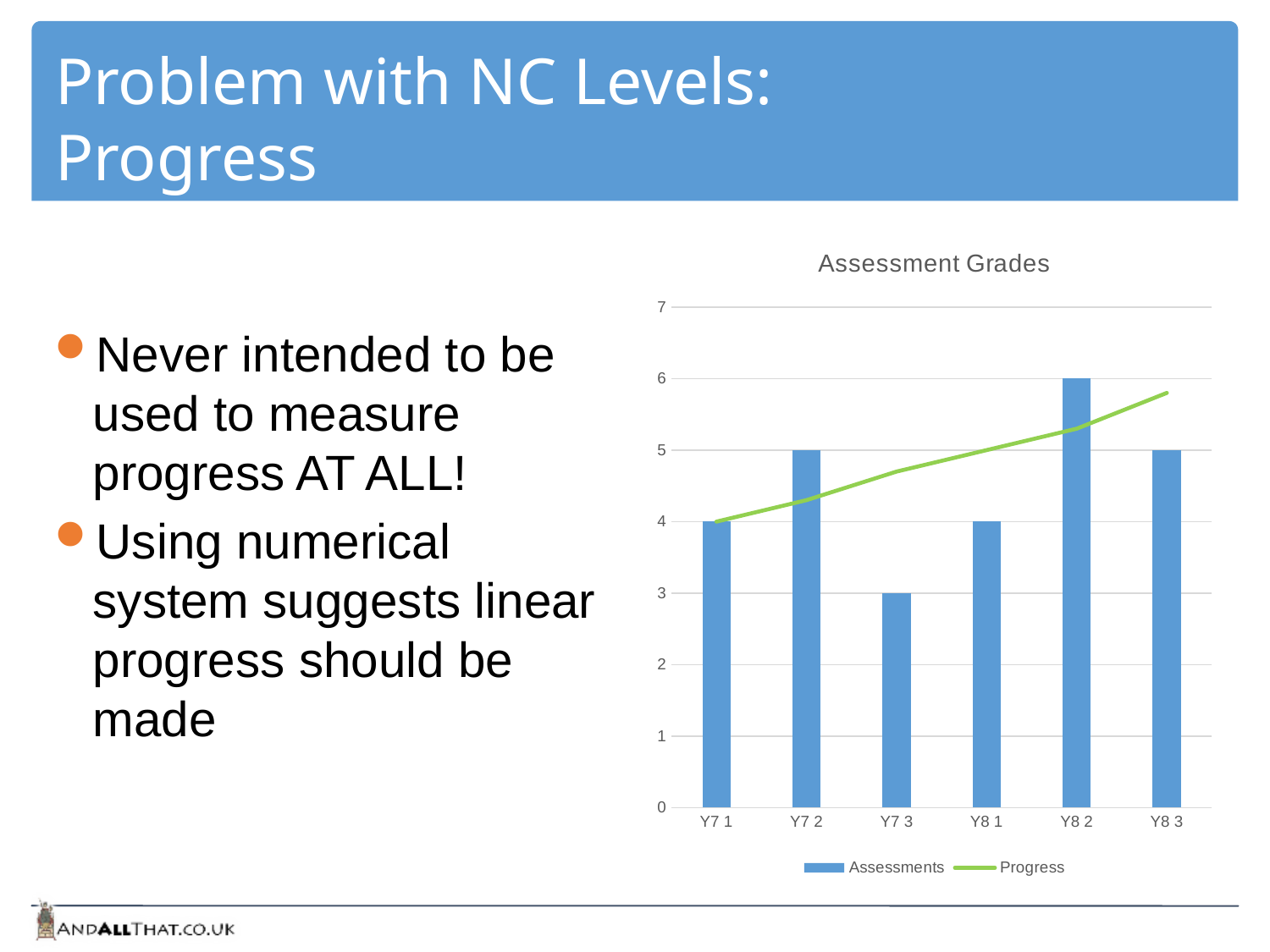
Which category has the lowest Assessments value? Y7 3 Which has the larger Assessments value, Y7 2 or Y8 1? Y7 2 Is the Progress value at Y8 3 greater or less than 5? greater What is the difference between the Assessments values for Y8 2 and Y7 3? 3 What kind of chart is shown on the slide? bar chart with a line How many categories are shown on the x axis? 6 What is the Assessments value for Y8 2? 6 What is the title of the chart? Assessment Grades Which category has the highest Assessments value? Y8 2 What is the Assessments value for Y7 3? 3 How many series does the legend list? 2 What is the Assessments value for Y7 1? 4